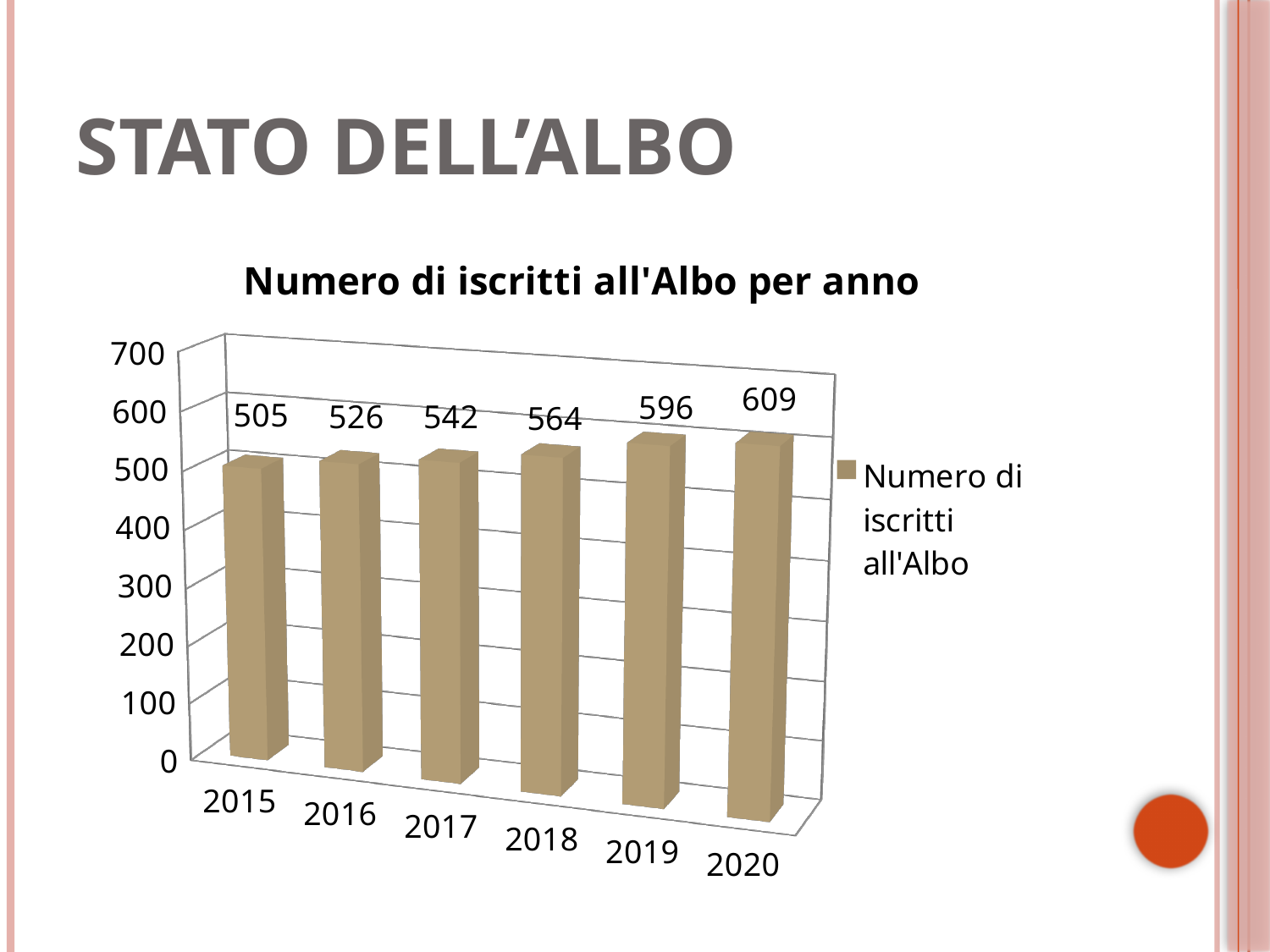
Do the values rise or fall from 2015 to 2020? Rise How many series does the legend list? 1 What kind of chart is shown on the slide? Bar chart What is the number of iscritti all'Albo for 2020? 609 Which year has the highest number of iscritti all'Albo? 2020 What is the difference between the number of iscritti in 2019 and in 2018? 32 What is the number of iscritti all'Albo for 2015? 505 Which year has the lowest number of iscritti all'Albo? 2015 What is the number of iscritti all'Albo for 2018? 564 Which year has more iscritti all'Albo, 2016 or 2017? 2017 How many years are shown on the x axis of the chart? 6 What is the difference between the number of iscritti in 2020 and in 2015? 104